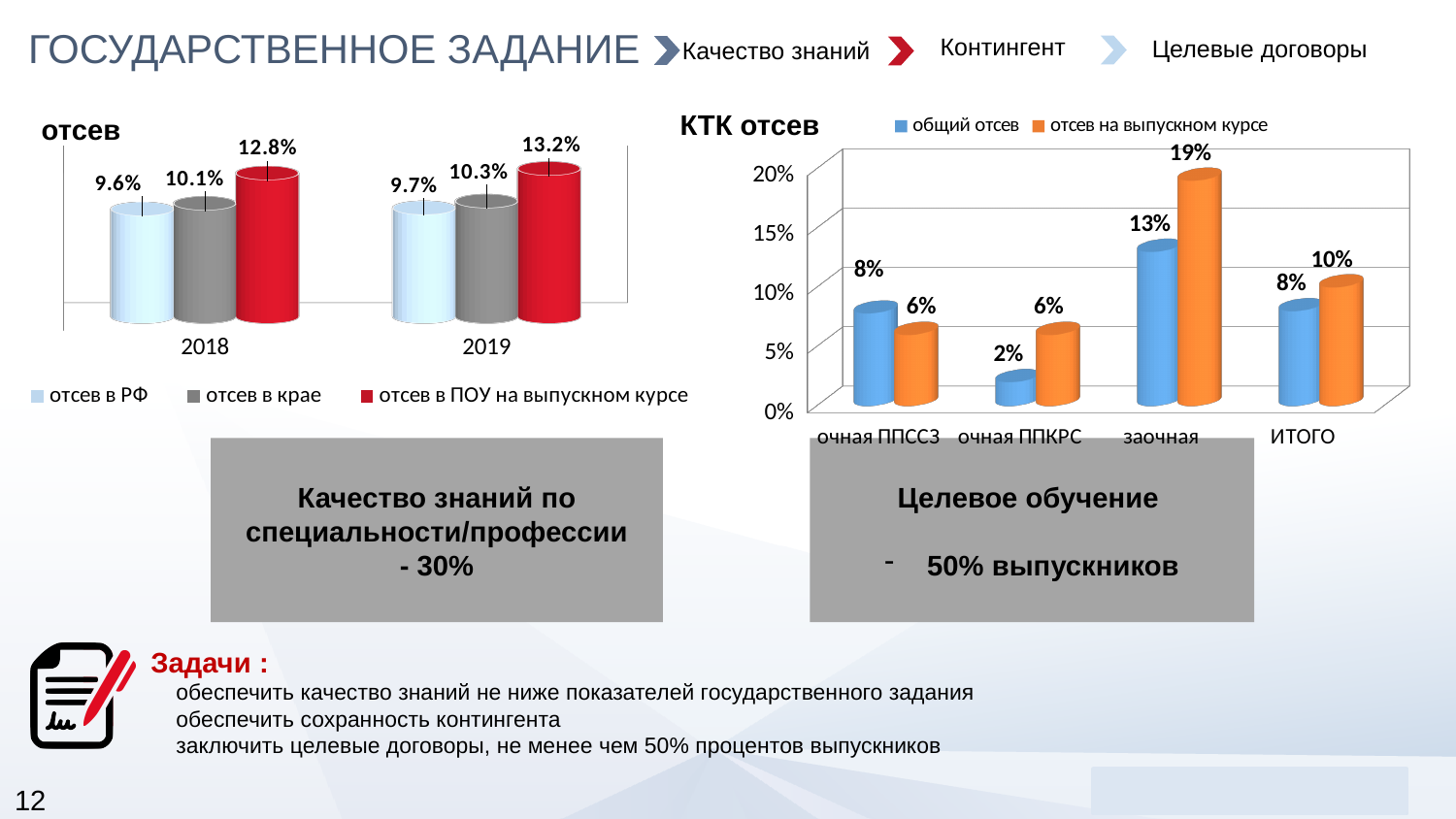
In the 'отсев' chart, how many series does the legend list? 3 In the 'КТК отсев' chart, which is larger for 'очная ППССЗ': 'общий отсев' or 'отсев на выпускном курсе'? общий отсев In the 'КТК отсев' chart, what is the value of 'отсев на выпускном курсе' for 'заочная'? 19% In the 'КТК отсев' chart, how many categories are shown on the x axis? 4 In the 'КТК отсев' chart, which category has the highest value for 'отсев на выпускном курсе'? заочная In the 'отсев' chart, does 'отсев в ПОУ на выпускном курсе' rise or fall from 2018 to 2019? rise In the 'отсев' chart, what is the value for 'отсев в ПОУ на выпускном курсе' in 2019? 13.2% What kind of chart is the 'КТК отсев' chart? bar chart In the 'КТК отсев' chart, which category has the lowest value for 'общий отсев'? очная ППКРС In the 'отсев' chart, what is the value for 'отсев в РФ' in 2018? 9.6% In the 'КТК отсев' chart, what is the difference between 'отсев на выпускном курсе' and 'общий отсев' for 'ИТОГО'? 2% In the 'отсев' chart, what is the difference between 'отсев в крае' in 2019 and in 2018? 0.2%